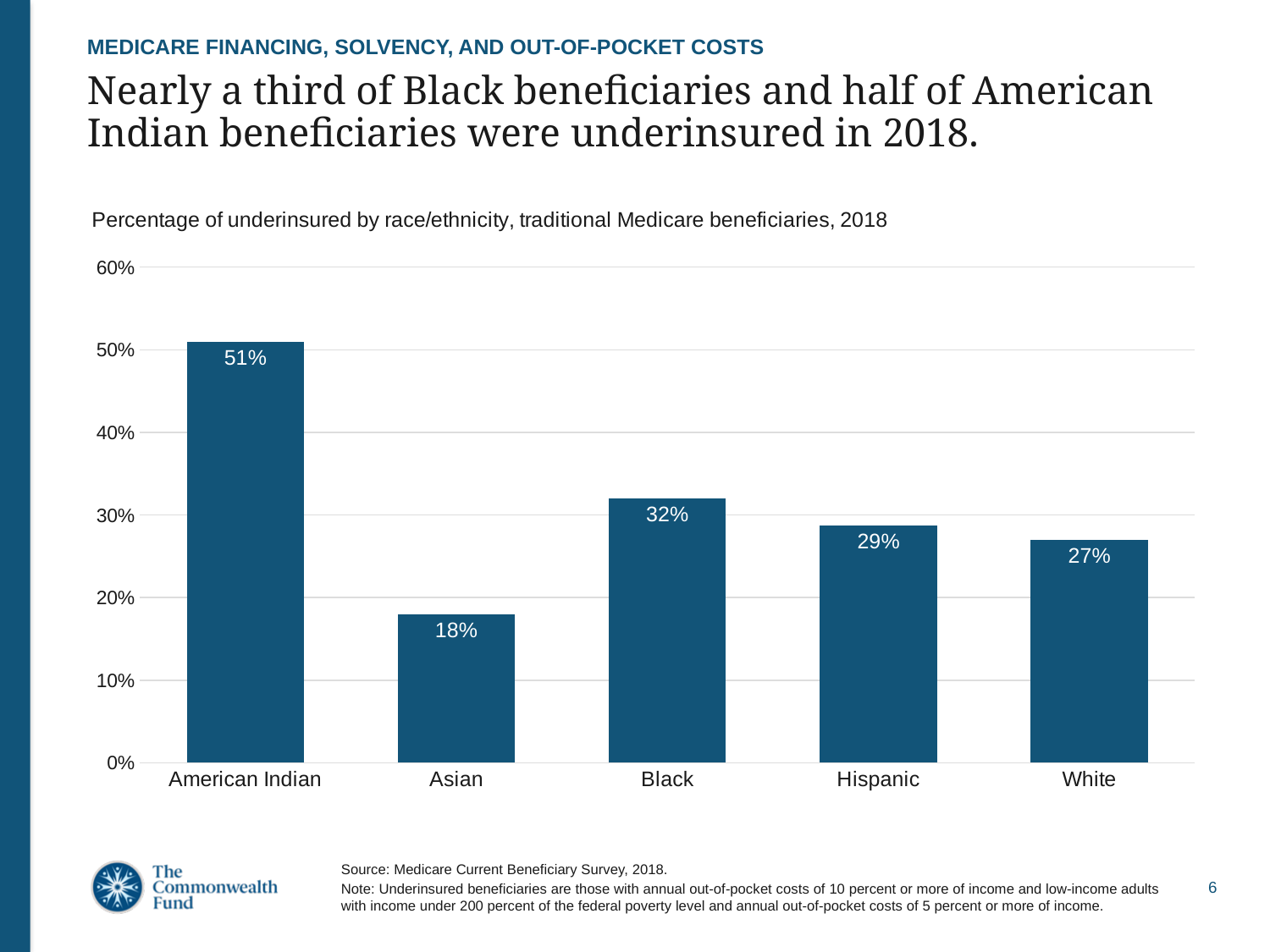
What is the difference in percentage points between Hispanic and White beneficiaries? 2 Which race/ethnicity group has the highest percentage of underinsured beneficiaries? American Indian What is the difference in percentage points between American Indian and Black beneficiaries? 19 What kind of chart is shown on the slide? Bar chart What percentage of Black beneficiaries were underinsured? 32% Is the value for Black beneficiaries greater or less than 30%? greater What is the value shown for Asian beneficiaries? 18% Which group has a higher underinsured percentage, Hispanic or Asian? Hispanic What is the value shown for White beneficiaries? 27% What percentage of American Indian traditional Medicare beneficiaries were underinsured in 2018? 51% How many race/ethnicity categories are shown in the chart? 5 Which race/ethnicity group has the lowest percentage of underinsured beneficiaries? Asian